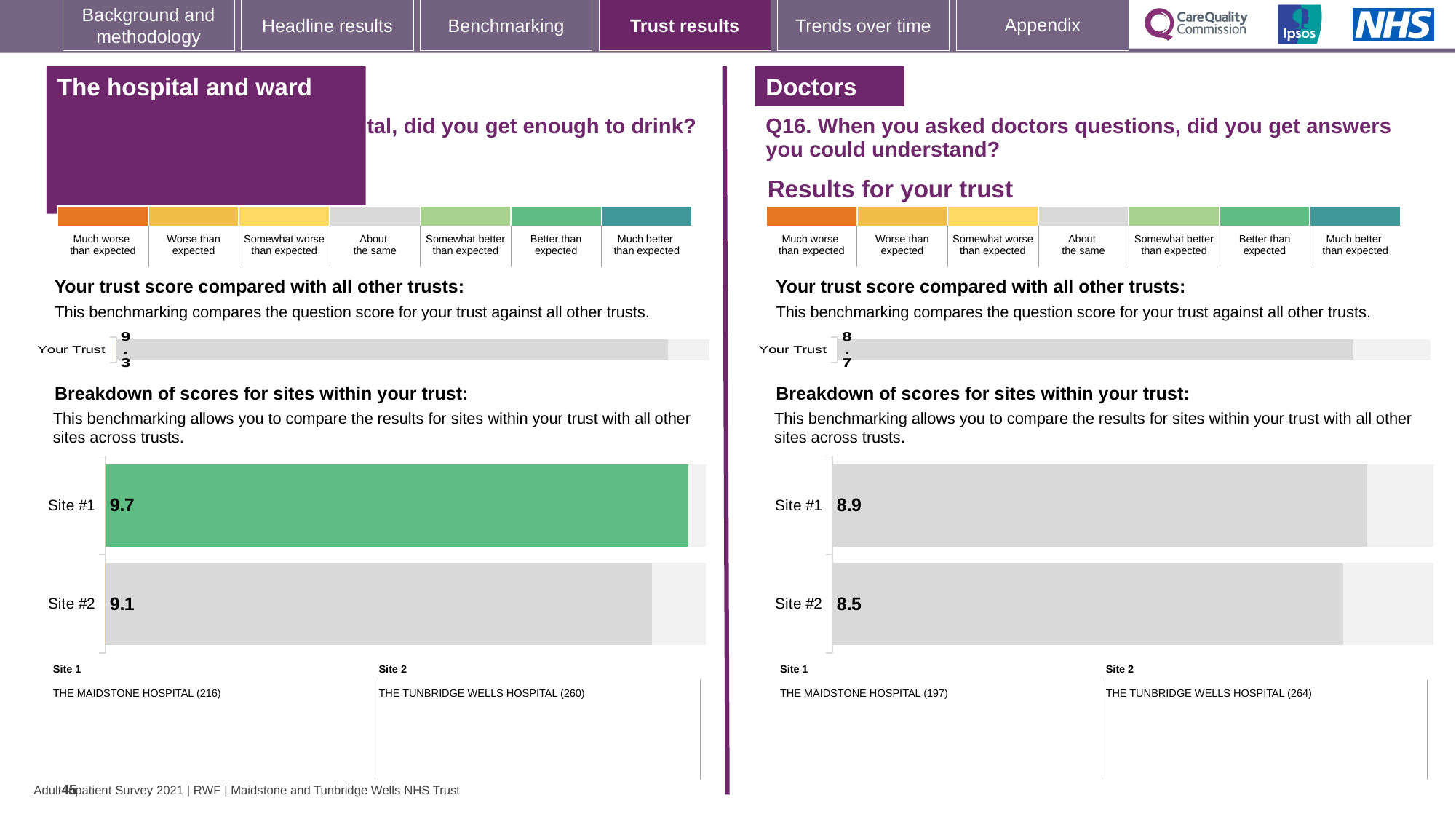
In the left-hand site breakdown chart, what is the difference between the Site #1 and Site #2 scores? 0.6 In the left-hand 'Breakdown of scores for sites within your trust' chart, what is the score for Site #2? 9.1 In the right-hand site breakdown chart (Doctors, Q16), what is the difference between the Site #1 and Site #2 scores? 0.4 In the left-hand site breakdown chart, which site has the higher score? Site #1 In the right-hand 'Breakdown of scores for sites within your trust' chart (Doctors, Q16), what is the score for Site #1? 8.9 How many sites are shown in the right-hand site breakdown chart (Doctors, Q16)? 2 In the right-hand 'Your trust score compared with all other trusts' chart (Doctors, Q16), what is the score for Your Trust? 8.7 In the right-hand site breakdown chart (Doctors, Q16), which site has the lower score? Site #2 In the left-hand 'Breakdown of scores for sites within your trust' chart, what is the score for Site #1? 9.7 What type of chart is used for the site breakdown on the left-hand side of the slide? Bar chart In the right-hand 'Breakdown of scores for sites within your trust' chart (Doctors, Q16), what is the score for Site #2? 8.5 In the left-hand 'Your trust score compared with all other trusts' chart (hospital and ward section), what is the score for Your Trust? 9.3